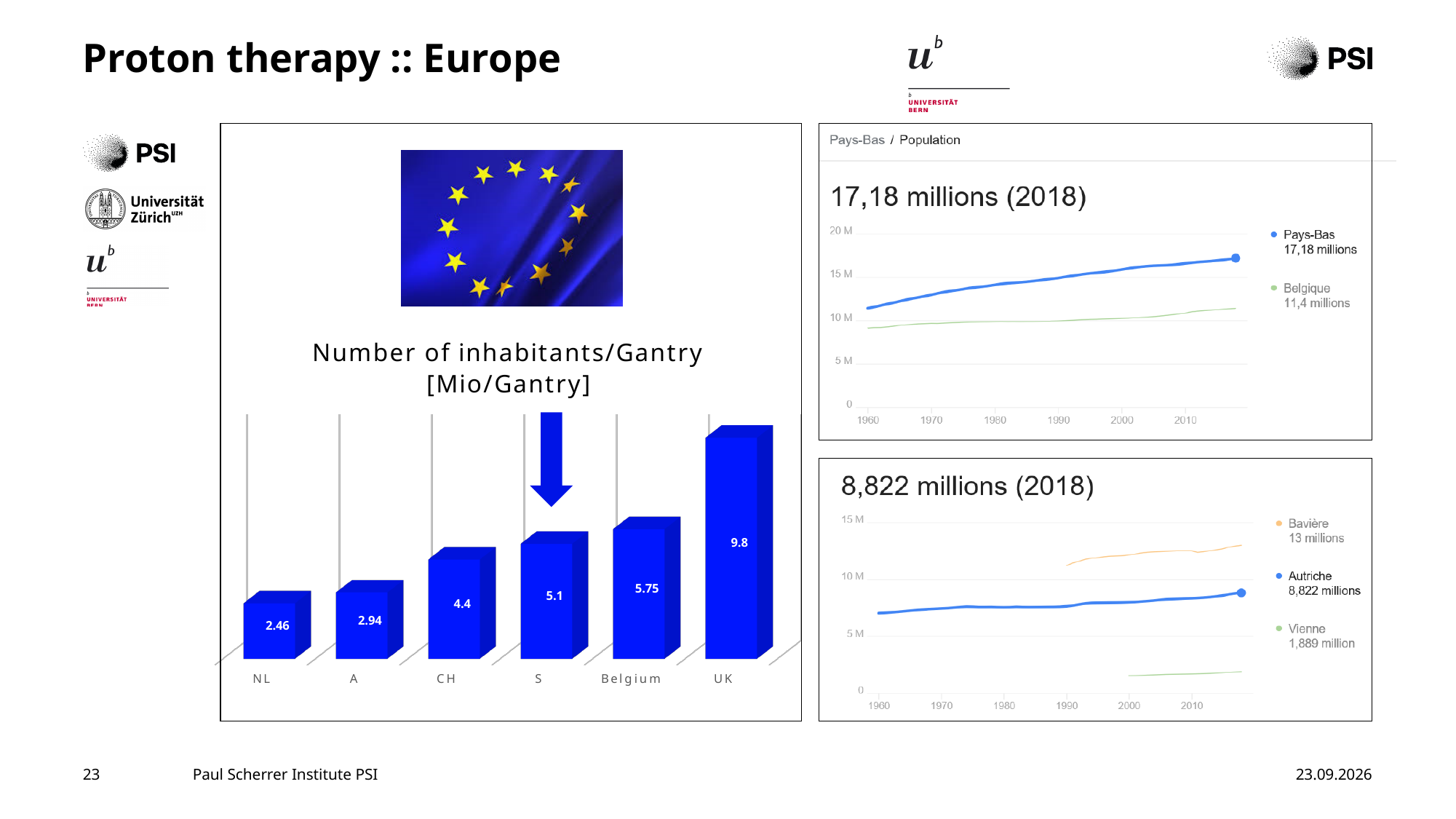
What kind of chart is the 'Number of inhabitants/Gantry' chart? bar chart In the 'Number of inhabitants/Gantry' bar chart, what is the difference between the values for UK and NL? 7.34 In the 'Pays-Bas / Population' line chart on the top right, what is the 2018 population value shown for Pays-Bas? 17,18 millions In the bottom-right line chart, what is the value shown for Vienne? 1,889 million Do the values in the 'Number of inhabitants/Gantry' bar chart rise or fall from left to right? rise In the 'Number of inhabitants/Gantry' bar chart, which is larger, the value for A or the value for S? S How many categories are shown in the 'Number of inhabitants/Gantry' bar chart? 6 In the 'Number of inhabitants/Gantry' bar chart, what is the value for Belgium? 5.75 In the 'Number of inhabitants/Gantry' bar chart, which category has the highest value? UK In the 'Number of inhabitants/Gantry' bar chart, what is the value for CH? 4.4 In the 'Pays-Bas / Population' line chart on the top right, what is the value shown for Belgique? 11,4 millions In the 'Number of inhabitants/Gantry' bar chart, which category has the lowest value? NL